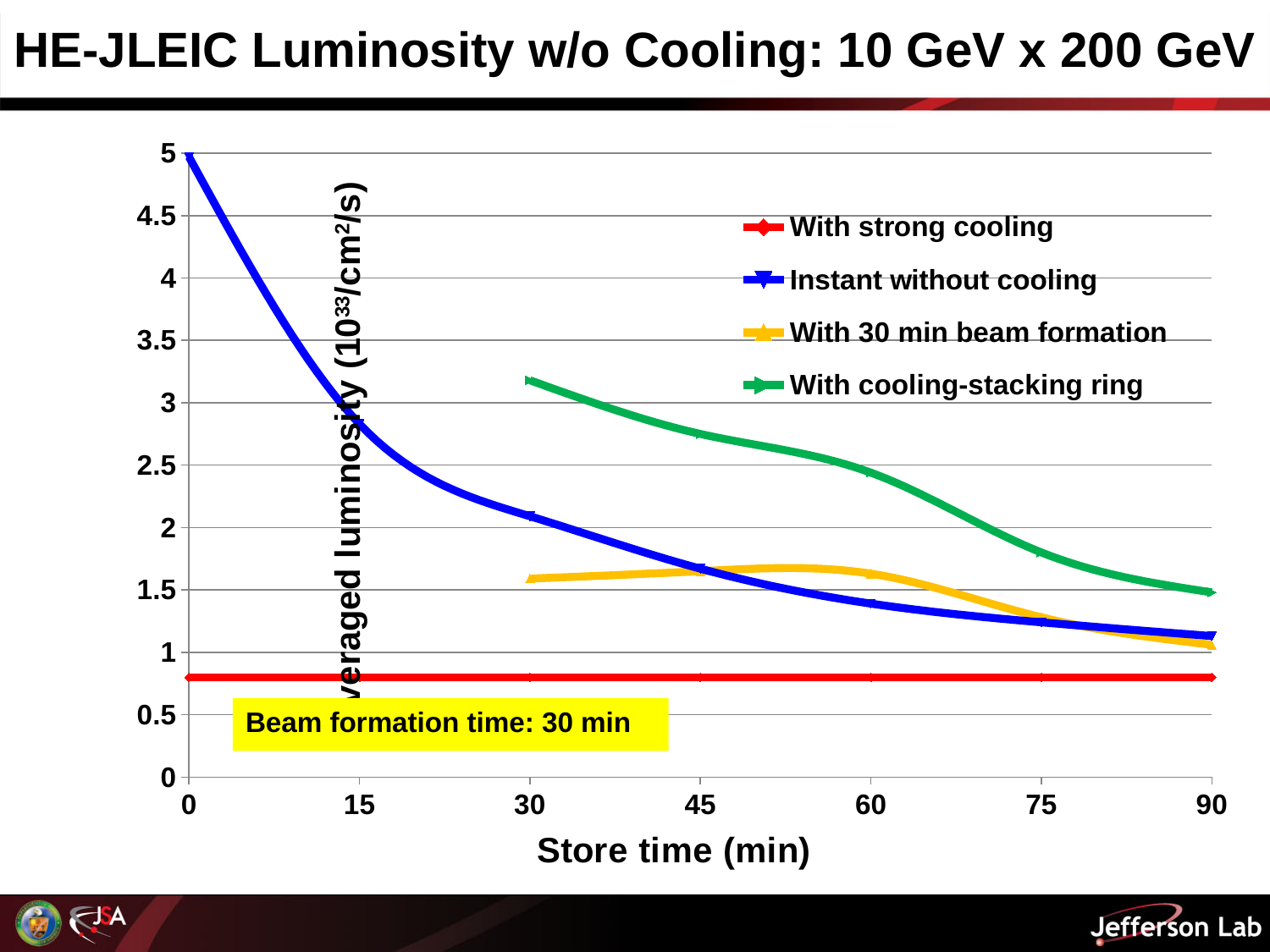
Does the 'Instant without cooling' series rise or fall as store time increases? fall Is the value of 'With strong cooling' at store time 60 min greater or less than 1? less Which series has the lowest value at store time 45 min? With strong cooling Is the value of 'With cooling-stacking ring' at store time 30 min greater or less than 3? greater How many series does the legend list? 4 Is the value of 'With cooling-stacking ring' at store time 75 min greater or less than 1.5? greater At store time 60 min, which series has the larger value: 'With cooling-stacking ring' or 'Instant without cooling'? With cooling-stacking ring Which series has the highest value at store time 60 min? With cooling-stacking ring What is the title of the x axis? Store time (min) What kind of chart is shown on the slide? line chart